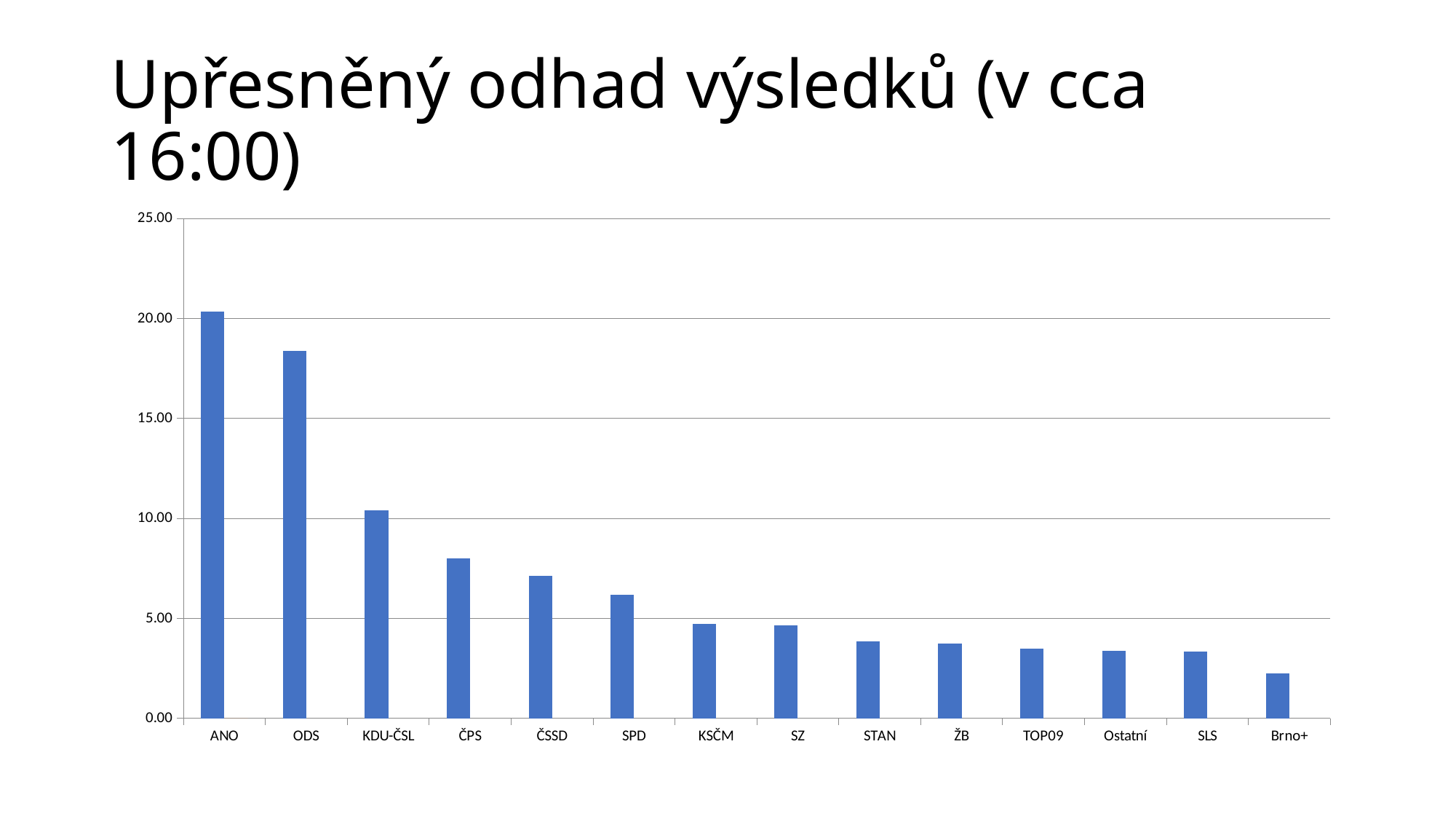
Which category has the highest value in the chart? ANO Do the values rise or fall from left to right along the x axis? fall How many categories are shown on the x axis of the chart? 14 What is the title of the slide containing the chart? Upřesněný odhad výsledků (v cca 16:00) What kind of chart is shown on the slide? bar chart Is the value for ANO greater or less than 15? greater Is the value for ČPS greater or less than 10? less Is the value for ODS greater or less than 20? less Which is larger, the value for ANO or the value for ODS? ANO Which category has the lowest value in the chart? Brno+